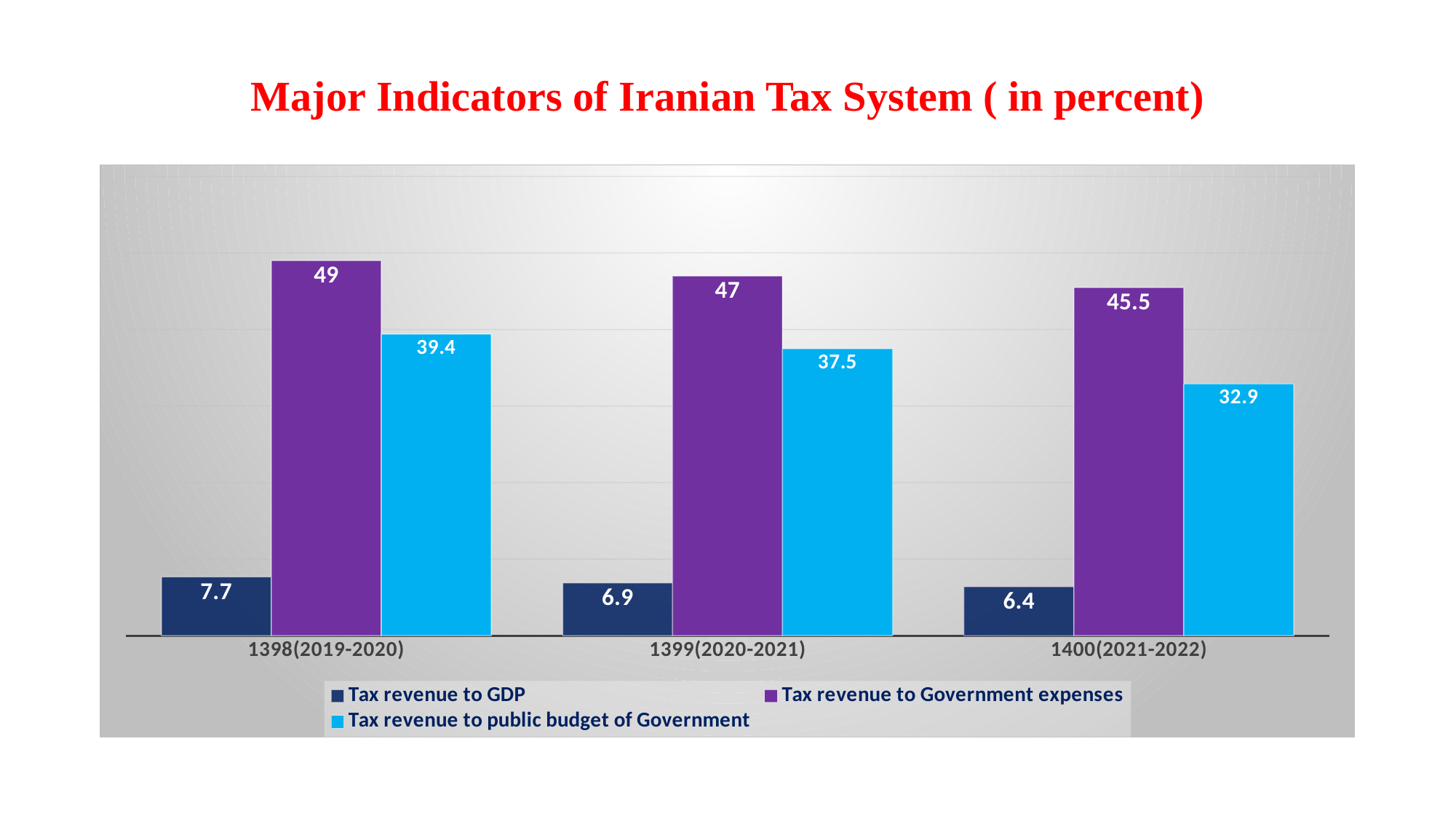
What kind of chart is shown on the slide? Bar chart Which is larger: Tax revenue to Government expenses in 1399(2020-2021) or Tax revenue to public budget of Government in 1398(2019-2020)? Tax revenue to Government expenses in 1399(2020-2021) What is the value of Tax revenue to public budget of Government for 1399(2020-2021)? 37.5 How many years are shown on the x axis? 3 How many series does the legend list? 3 Does Tax revenue to GDP rise or fall from 1398(2019-2020) to 1400(2021-2022)? Fall What is the title of the chart? Major Indicators of Iranian Tax System ( in percent) What is the difference between Tax revenue to public budget of Government in 1398(2019-2020) and 1400(2021-2022)? 6.5 What is the value of Tax revenue to Government expenses for 1400(2021-2022)? 45.5 In which year is Tax revenue to Government expenses highest? 1398(2019-2020) What is the value of Tax revenue to GDP for 1398(2019-2020)? 7.7 In which year is Tax revenue to GDP lowest? 1400(2021-2022)